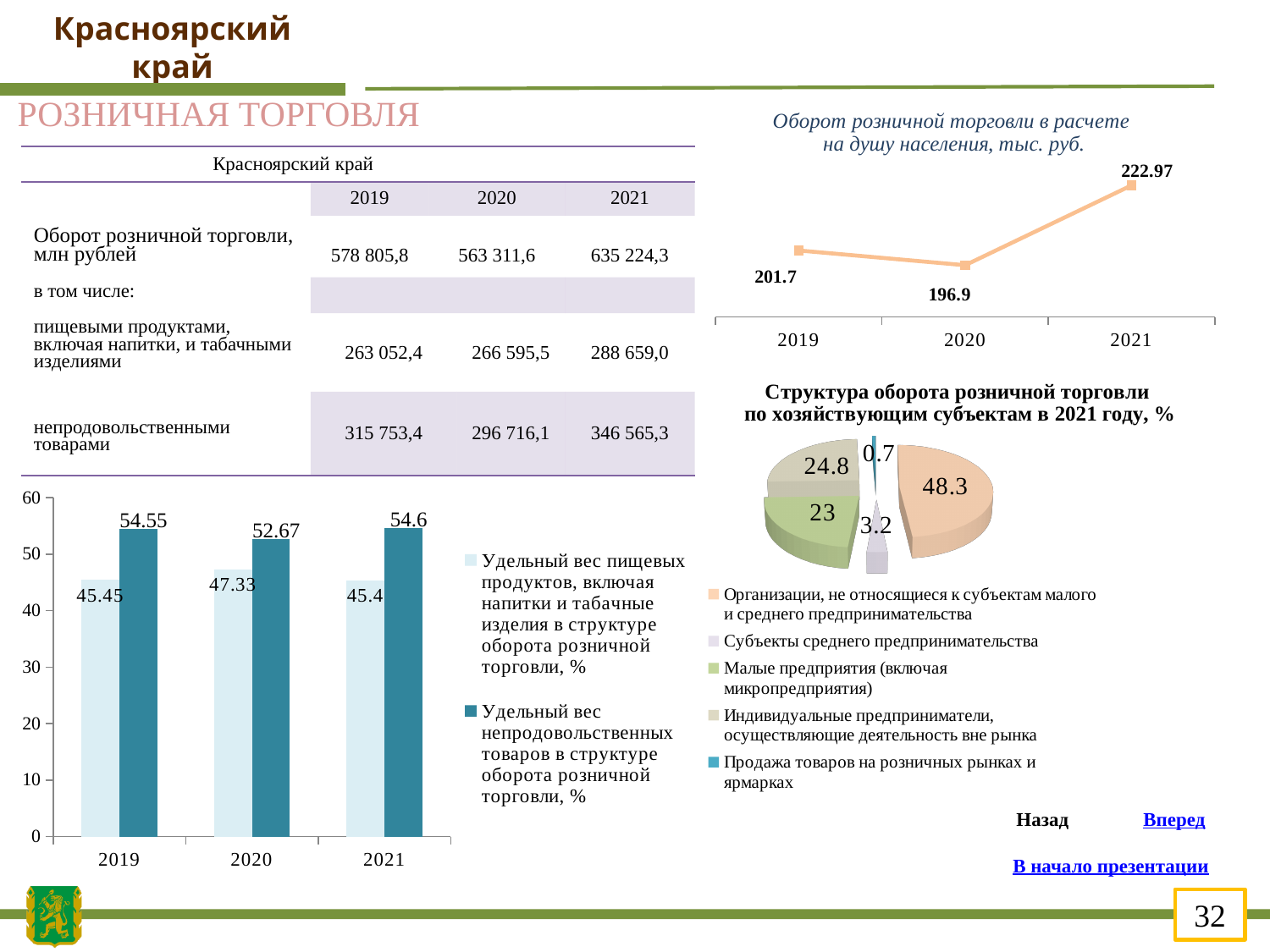
On the pie chart 'Структура оборота розничной торговли по хозяйствующим субъектам в 2021 году, %', what share do 'Малые предприятия (включая микропредприятия)' have? 23 On the pie chart 'Структура оборота розничной торговли по хозяйствующим субъектам в 2021 году, %', which category has the largest slice? Организации, не относящиеся к субъектам малого и среднего предпринимательства On the bar chart at the bottom left, in which year is 'Удельный вес пищевых продуктов, включая напитки и табачные изделия в структуре оборота розничной торговли, %' highest? 2020 On the bar chart at the bottom left, what is the difference between the non-food share and the food share in 2020? 5.34 On the pie chart 'Структура оборота розничной торговли по хозяйствующим субъектам в 2021 году, %', which category has the smallest slice? Продажа товаров на розничных рынках и ярмарках How many series does the legend of the bar chart at the bottom left list? 2 On the line chart 'Оборот розничной торговли в расчете на душу населения, тыс. руб.', what is the value for 2021? 222.97 On the line chart 'Оборот розничной торговли в расчете на душу населения, тыс. руб.', which year has the lowest value? 2020 How many years are shown on the x axis of the bar chart at the bottom left? 3 On the bar chart at the bottom left, what is the value for 'Удельный вес непродовольственных товаров в структуре оборота розничной торговли, %' in 2020? 52.67 What kind of chart is the chart titled 'Оборот розничной торговли в расчете на душу населения, тыс. руб.'? line chart On the line chart 'Оборот розничной торговли в расчете на душу населения, тыс. руб.', by how much does the 2021 value exceed the 2020 value? 26.07